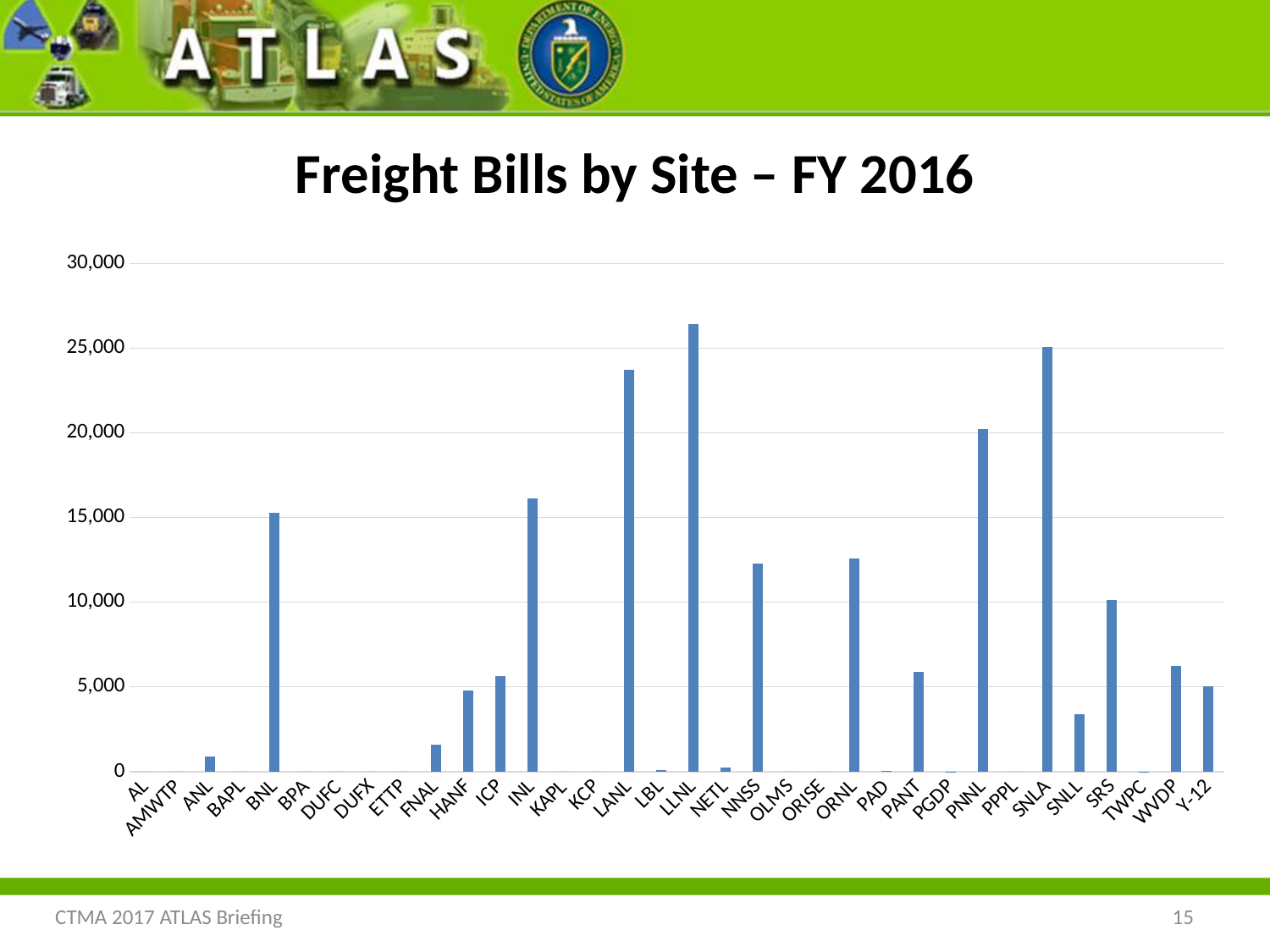
What kind of chart is shown on the slide? bar chart Is the value for WVDP greater or less than 5,000? greater Is the value for SNLL greater or less than 5,000? less Which site has the highest number of freight bills? LLNL Which site has more freight bills, SNLA or PNNL? SNLA Is the value for INL greater or less than 15,000? greater Which site has more freight bills, BNL or INL? INL How many sites are shown along the x axis of the chart? 34 Which site has more freight bills, LANL or PNNL? LANL What is the title of the chart? Freight Bills by Site – FY 2016